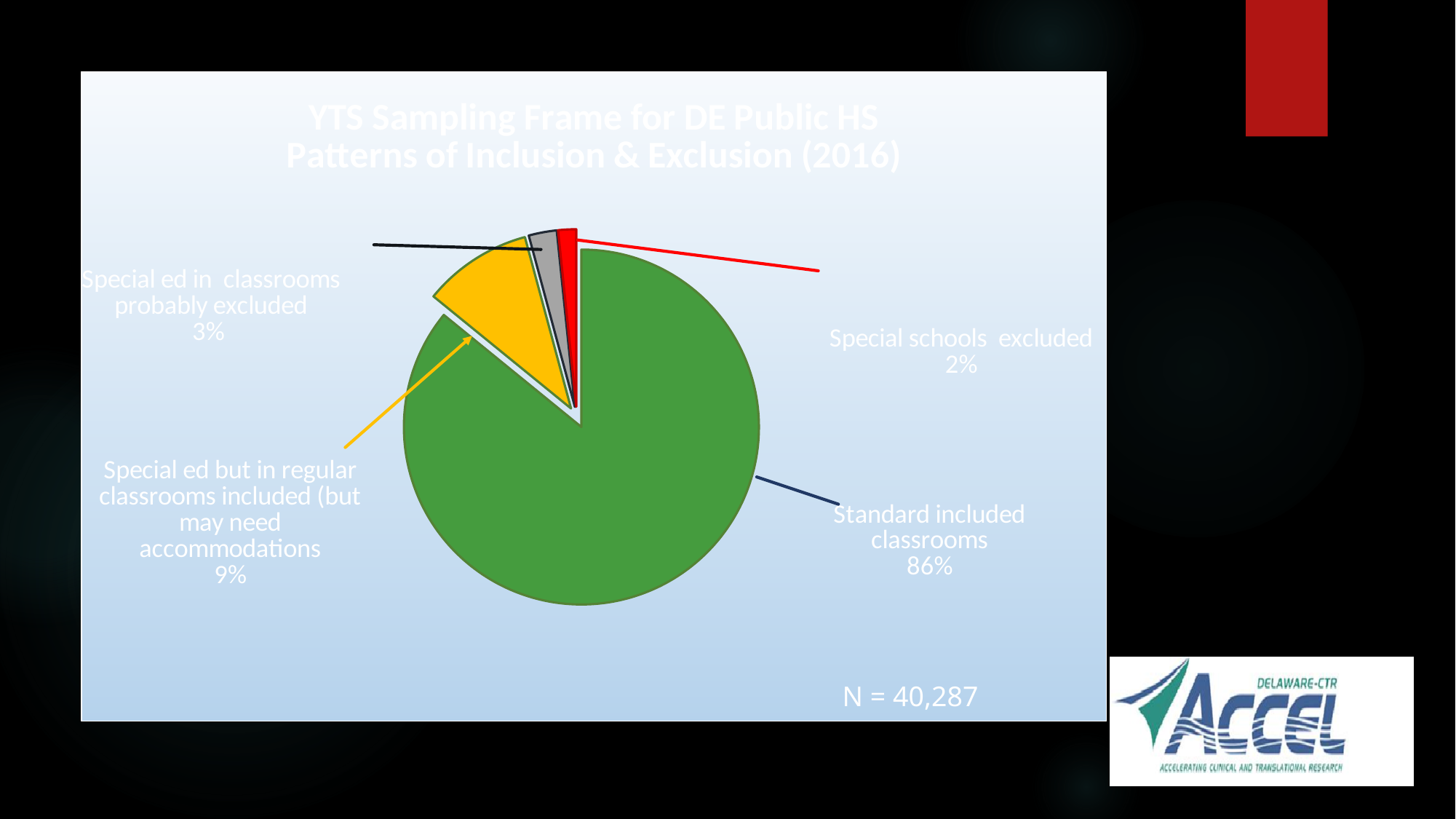
What is the difference in percentage points between "Standard included classrooms" and "Special ed but in regular classrooms included"? 77 What is the value of N shown on the chart? N = 40,287 What share of the pie is labelled "Special schools excluded"? 2% What colour is the "Standard included classrooms" slice? Green Which slice of the pie is the smallest? Special schools excluded What kind of chart is shown on the slide? Pie chart What share of the pie is labelled "Special ed in classrooms probably excluded"? 3% What share of the pie is labelled "Standard included classrooms"? 86% Which slice of the pie is the largest? Standard included classrooms How many slices does the pie chart have? 4 Which is larger: the share for "Special ed in classrooms probably excluded" or the share for "Special schools excluded"? Special ed in classrooms probably excluded